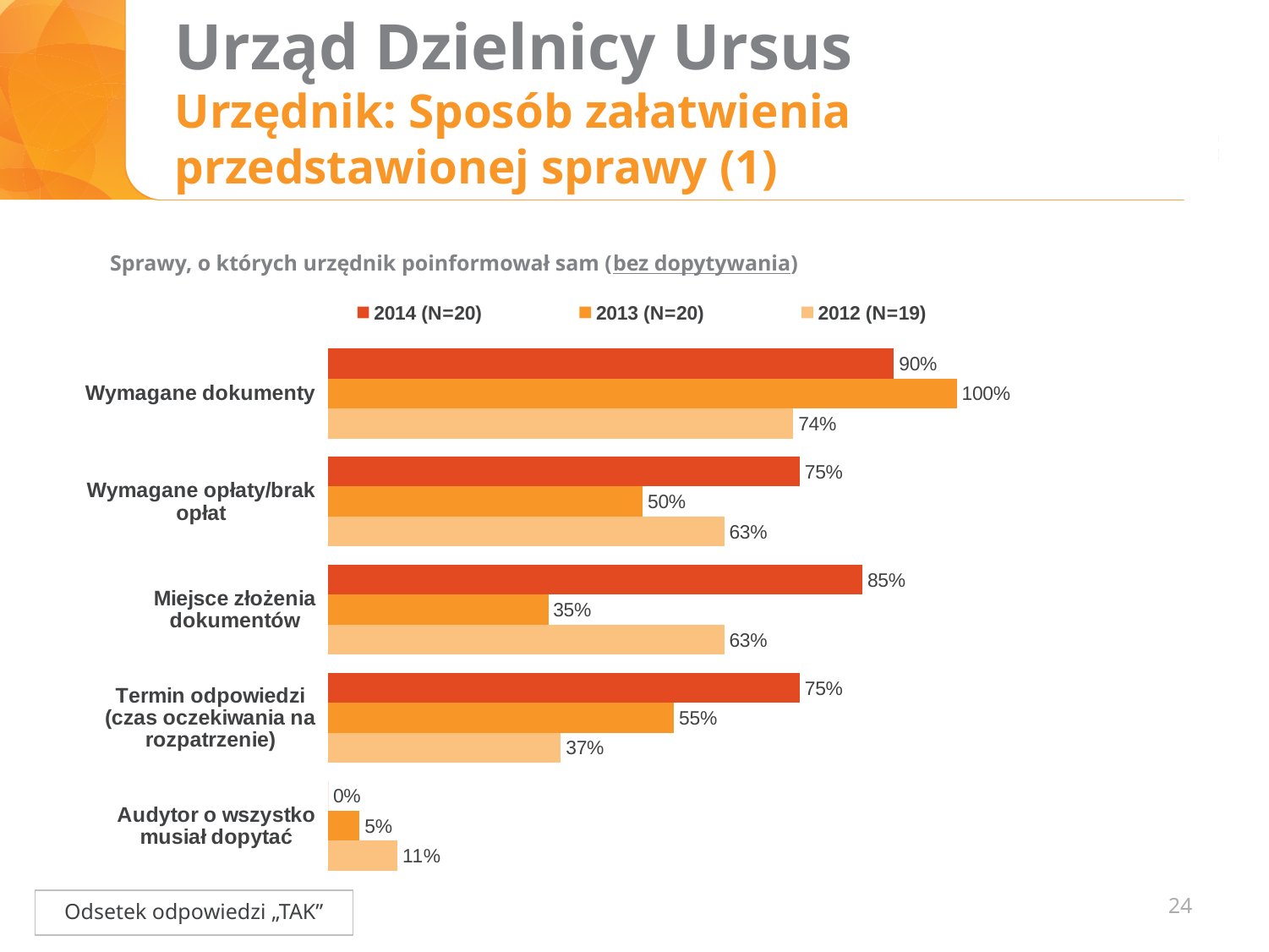
What is the value for "Wymagane dokumenty" in the 2013 (N=20) series? 100% How many series does the legend list? 3 What is the difference between the 2014 (N=20) and 2013 (N=20) values for "Miejsce złożenia dokumentów"? 50 percentage points What is the value for "Termin odpowiedzi (czas oczekiwania na rozpatrzenie)" in the 2012 (N=19) series? 37% Which category has the lowest value in the 2013 (N=20) series? Audytor o wszystko musiał dopytać What is the value for "Audytor o wszystko musiał dopytać" in the 2014 (N=20) series? 0% What is the subtitle text shown above the chart? Sprawy, o których urzędnik poinformował sam (bez dopytywania) What is the value for "Miejsce złożenia dokumentów" in the 2014 (N=20) series? 85% Which category has the highest value in the 2014 (N=20) series? Wymagane dokumenty What kind of chart is shown on the slide? Bar chart How many categories are shown on the chart? 5 For "Wymagane opłaty/brak opłat", which series has the larger value: 2013 (N=20) or 2012 (N=19)? 2012 (N=19)